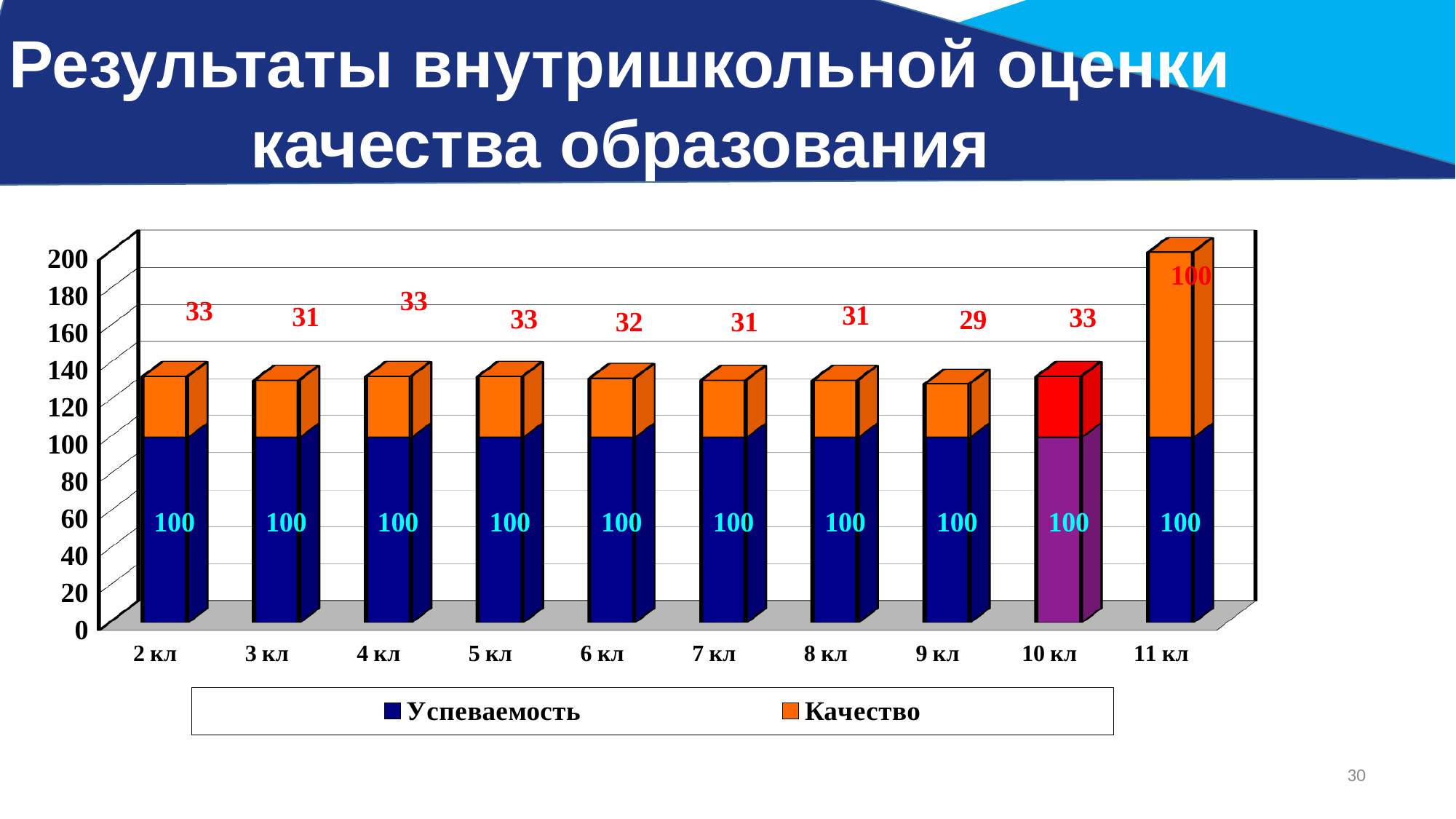
Which class has the highest Качество value? 11 кл What is the Качество value for 8 кл? 31 What is the total of the stacked bar for 2 кл? 133 What is the difference between the Качество values for 11 кл and 9 кл? 71 Which class has the lowest Качество value? 9 кл What is the Качество value for 9 кл? 29 What kind of chart is shown on the slide? Stacked bar chart Which is larger, the Качество value for 6 кл or for 7 кл? 6 кл What is the Успеваемость value for 6 кл? 100 How many classes are shown on the x axis? 10 How many series does the legend list? 2 What is the Качество value for 11 кл? 100